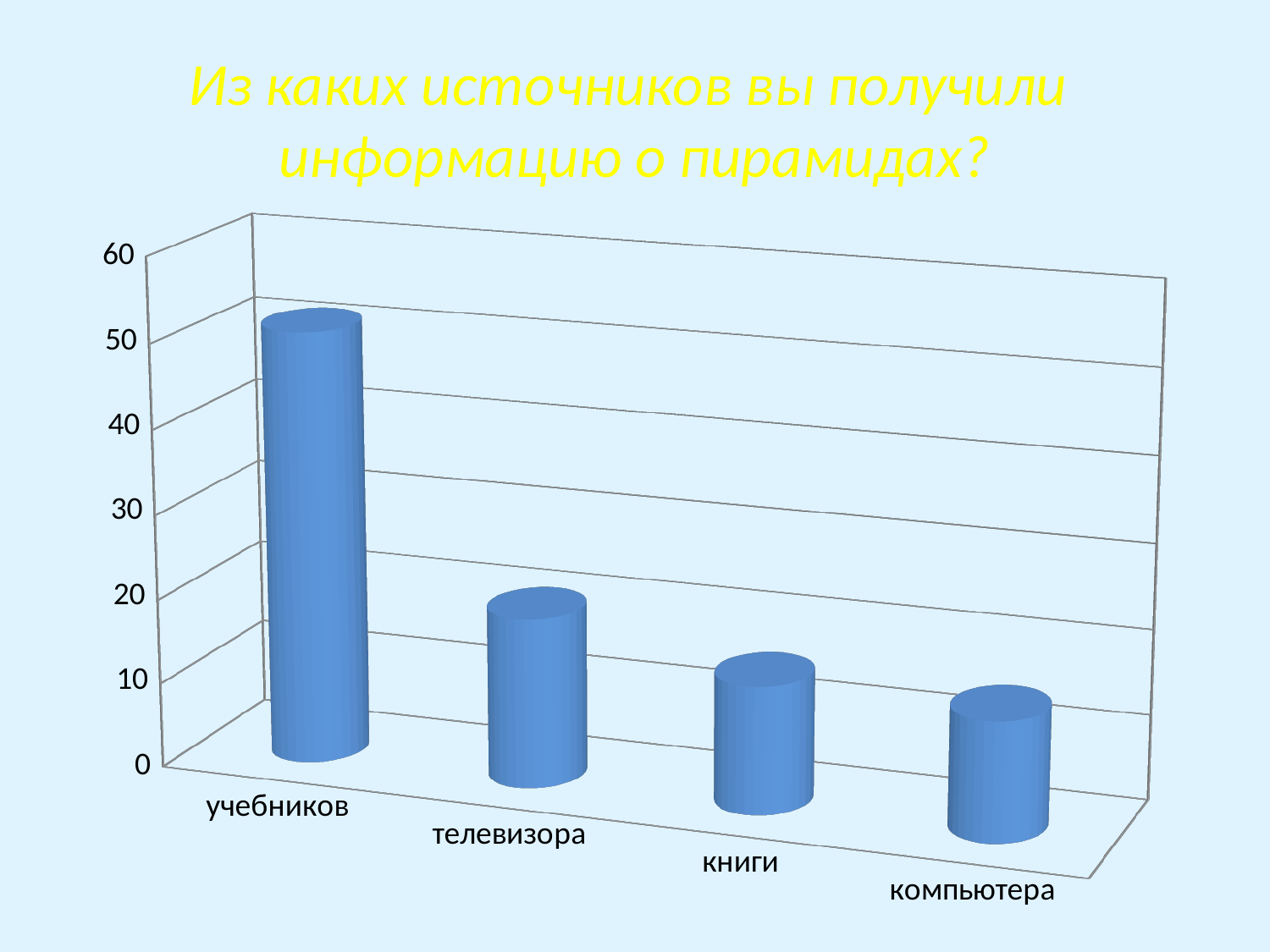
Which is larger, the value for учебников or the value for компьютера? учебников Do the values rise or fall from left to right across the categories? fall Which category has the lowest value? компьютера Is the value for книги greater or less than 30? less Is the value for учебников greater or less than 40? greater Is the value for компьютера greater or less than 20? less What is the title of the slide? Из каких источников вы получили информацию о пирамидах? Which is larger, the value for телевизора or the value for книги? телевизора What kind of chart is shown on the slide? bar chart Which category has the highest value? учебников How many categories are shown in the chart? 4